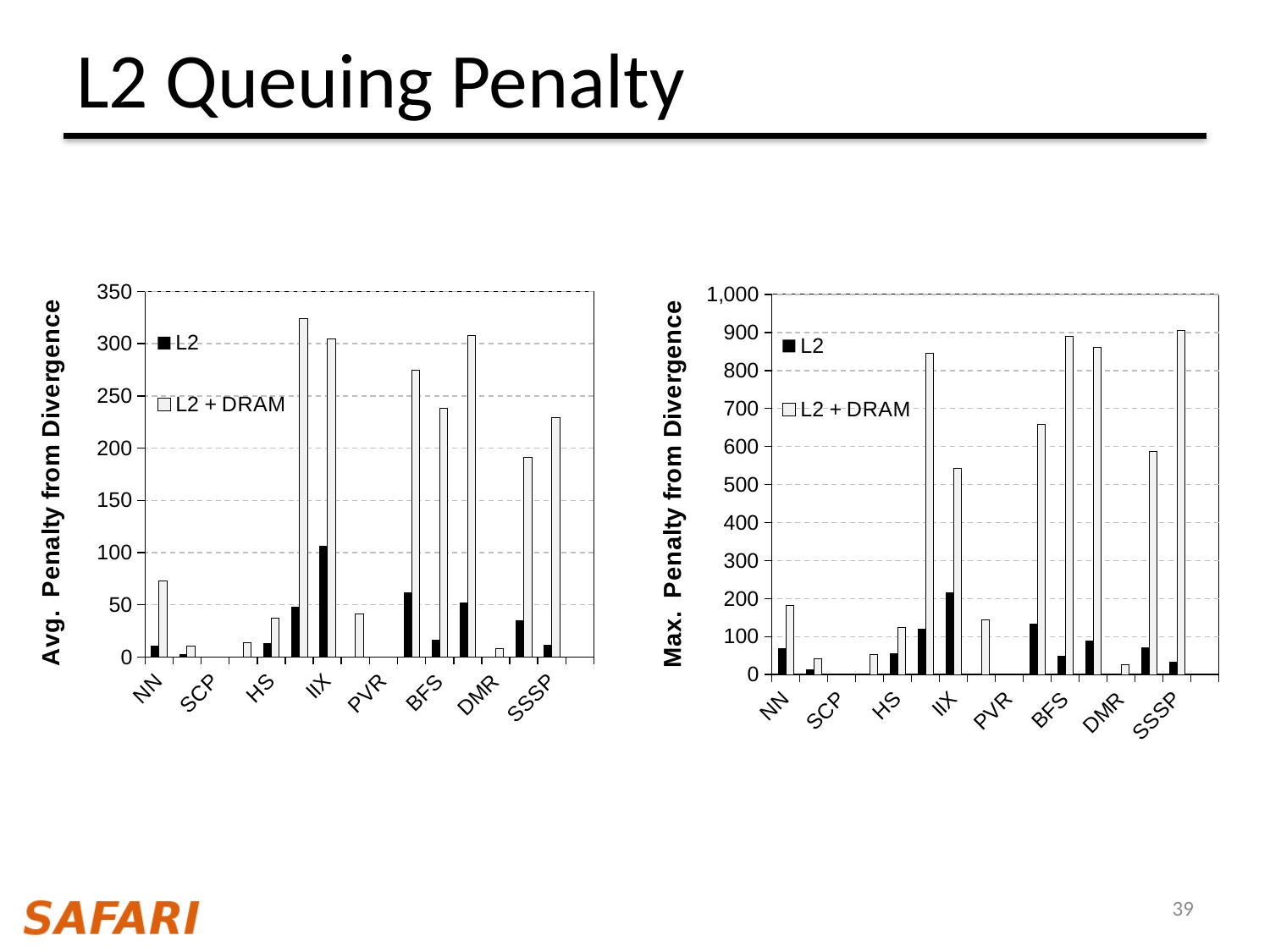
In the right chart (Max. Penalty from Divergence), is the tallest L2 bar for IIX greater or less than 100? greater What kind of chart is the left chart (Avg. Penalty from Divergence)? bar chart In the left chart (Avg. Penalty from Divergence), is the tallest L2 bar for IIX greater or less than 50? greater What is the y-axis label of the right chart? Max. Penalty from Divergence In the right chart (Max. Penalty from Divergence), is the tallest L2 + DRAM bar for NN greater or less than 100? greater In the right chart (Max. Penalty from Divergence), which category has the highest L2 bar? IIX In the left chart (Avg. Penalty from Divergence), which category has the highest L2 bar? IIX How many series does the legend of the right chart (Max. Penalty from Divergence) list? 2 In the right chart (Max. Penalty from Divergence), is the tallest L2 + DRAM bar for IIX larger or smaller than the tallest L2 + DRAM bar for PVR? larger